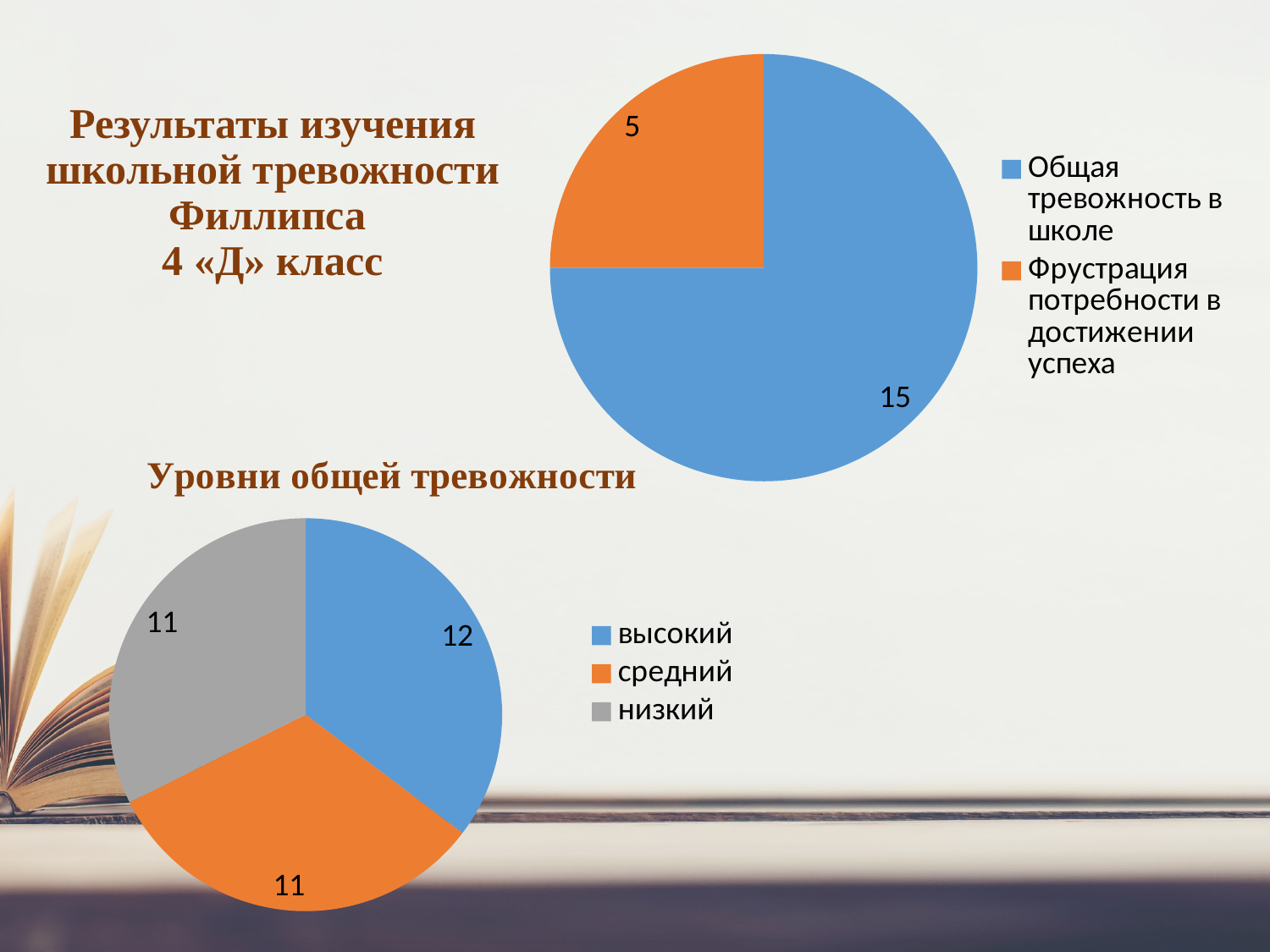
In the top-right pie chart, what is the value for «Общая тревожность в школе»? 15 In the top-right pie chart, what is the difference between the values for «Общая тревожность в школе» and «Фрустрация потребности в достижении успеха»? 10 In the top-right pie chart, which category has the largest slice? Общая тревожность в школе In the chart «Уровни общей тревожности», which category has the largest value? высокий What type of chart is «Уровни общей тревожности»? Pie chart In the chart «Уровни общей тревожности», what is the total of all slices? 34 In the top-right pie chart, what is the value for «Фрустрация потребности в достижении успеха»? 5 How many categories are shown in the chart «Уровни общей тревожности»? 3 In the chart «Уровни общей тревожности», what is the value for «средний»? 11 In the top-right pie chart, what share of the pie does «Фрустрация потребности в достижении успеха» represent? 25% How many categories does the legend of the top-right pie chart list? 2 In the chart «Уровни общей тревожности», what is the value for «высокий»? 12